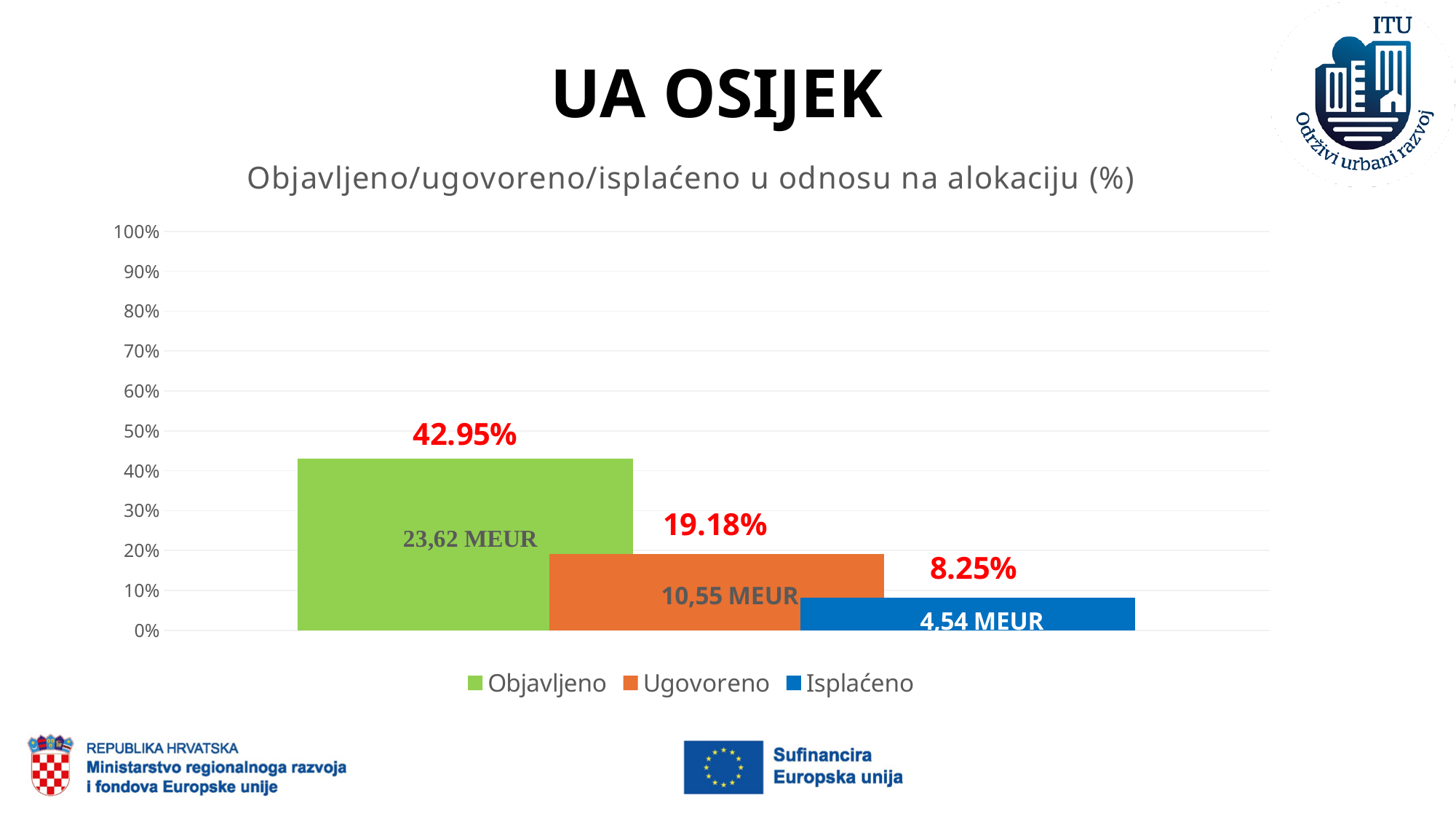
What percentage is shown for Ugovoreno? 19.18% What is the difference in MEUR between the Ugovoreno and Isplaćeno bars? 6,01 MEUR What percentage is shown for Isplaćeno? 8.25% What percentage is shown for Objavljeno? 42.95% Which series has the lowest percentage? Isplaćeno What amount in MEUR is labelled on the Isplaćeno bar? 4,54 MEUR How many series does the legend list? 3 What amount in MEUR is labelled on the Objavljeno bar? 23,62 MEUR Is the value for Ugovoreno greater or less than 20%? less Which series has the highest percentage? Objavljeno What type of chart is shown on the slide? Bar chart What is the difference in percentage points between Objavljeno and Ugovoreno? 23.77%